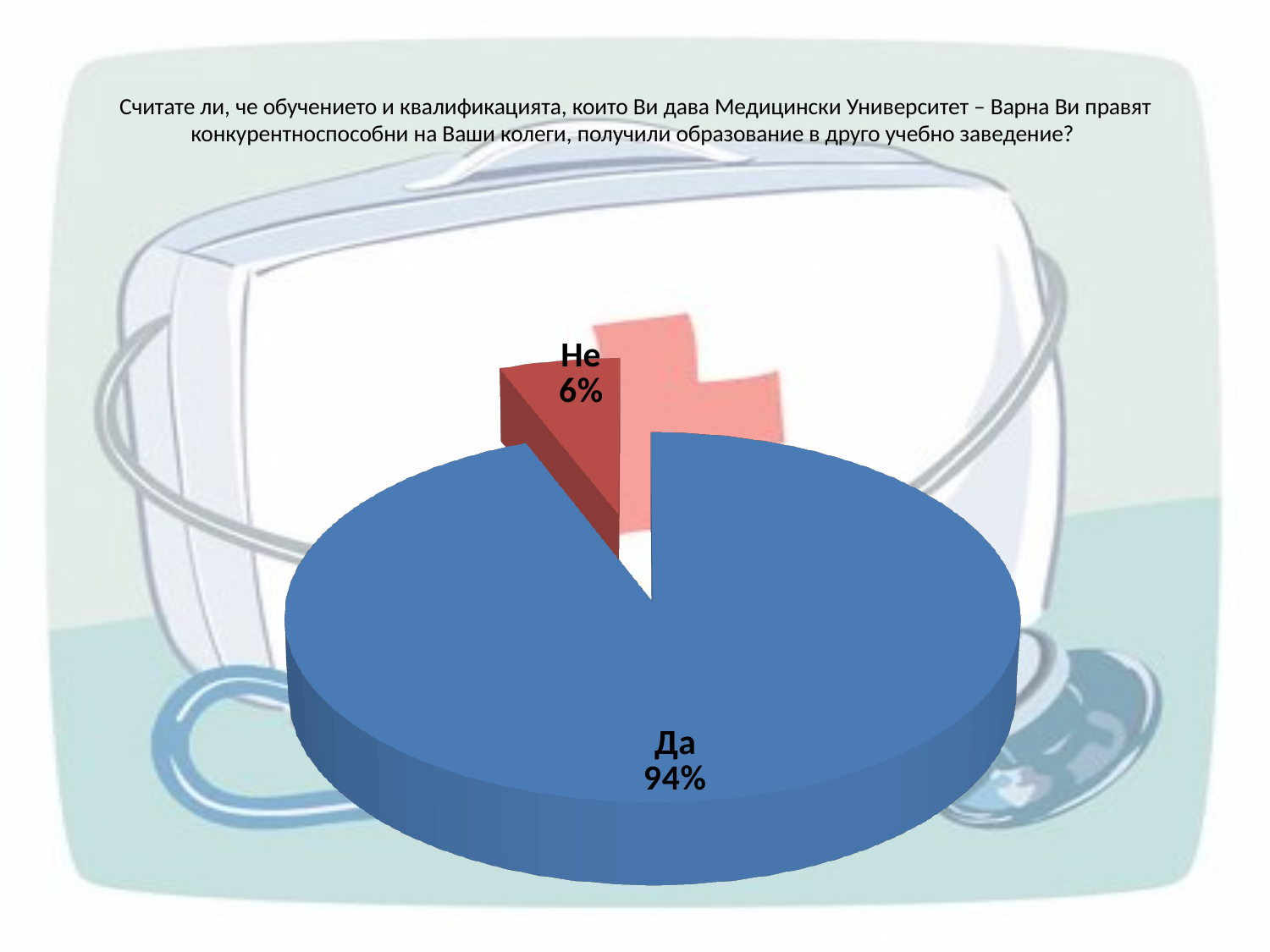
What kind of chart is shown on the slide? pie chart Which is larger, the "Да" slice or the "Не" slice? Да What colour is the "Да" slice? blue What share of the pie does the "Не" slice represent? 6% Which slice of the pie is the largest? Да How many slices does the pie chart have? 2 What is the difference in percentage points between the "Да" and "Не" slices? 88 What colour is the "Не" slice? red Which slice of the pie is the smallest? Не What share of the pie does the "Да" slice represent? 94%